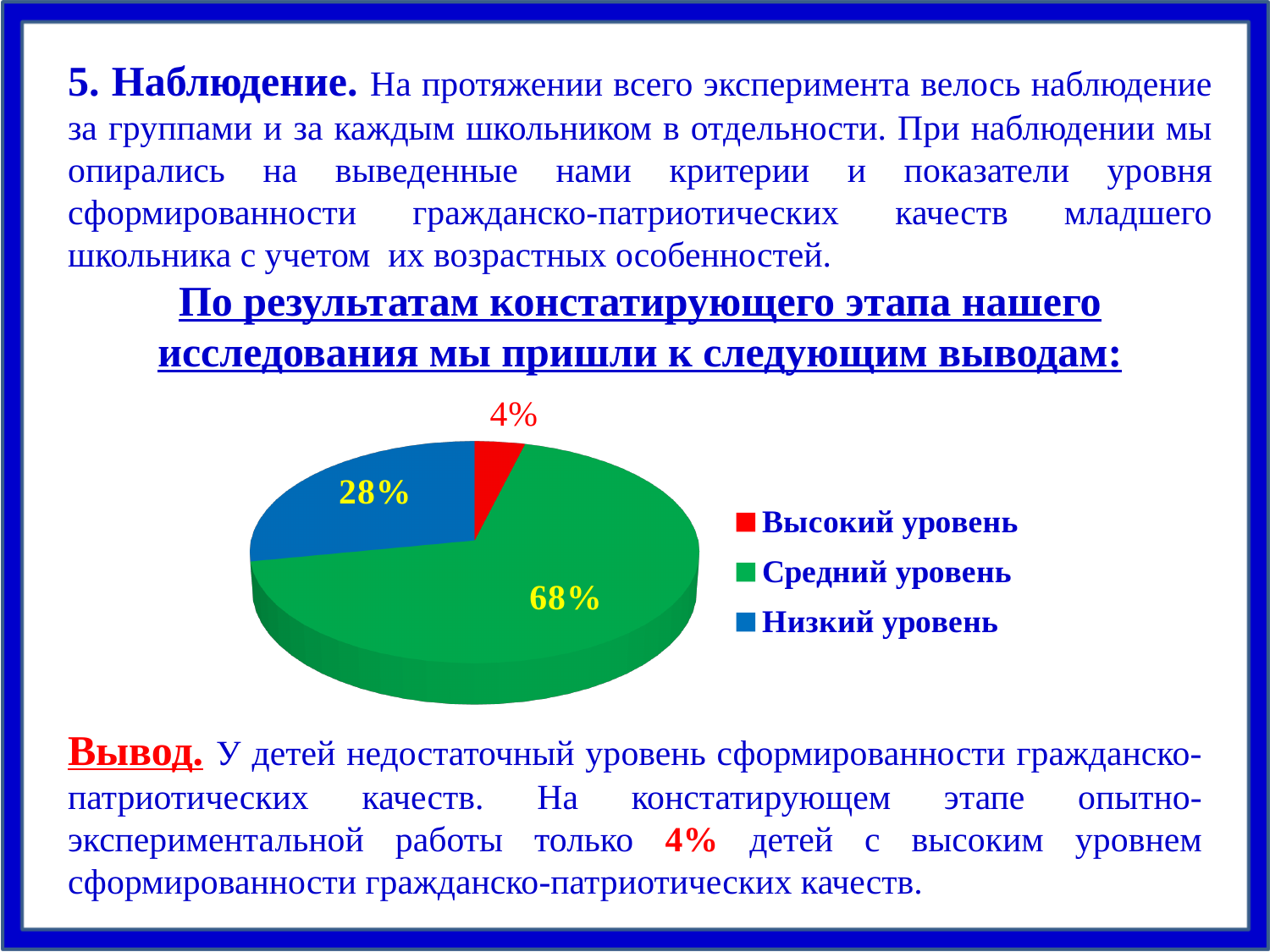
What is the difference between the shares of "Низкий уровень" and "Высокий уровень"? 24% What share of the pie does "Низкий уровень" have? 28% What is the difference between the shares of "Средний уровень" and "Низкий уровень"? 40% Which category has the smallest slice of the pie? Высокий уровень What colour is the slice for "Средний уровень"? green What share of the pie does "Высокий уровень" have? 4% Which is larger: the share of "Низкий уровень" or the share of "Высокий уровень"? Низкий уровень What share of the pie does "Средний уровень" have? 68% What kind of chart is shown on the slide? pie chart How many categories does the pie chart have? 3 Which legend entry is shown in red? Высокий уровень Which category has the largest slice of the pie? Средний уровень